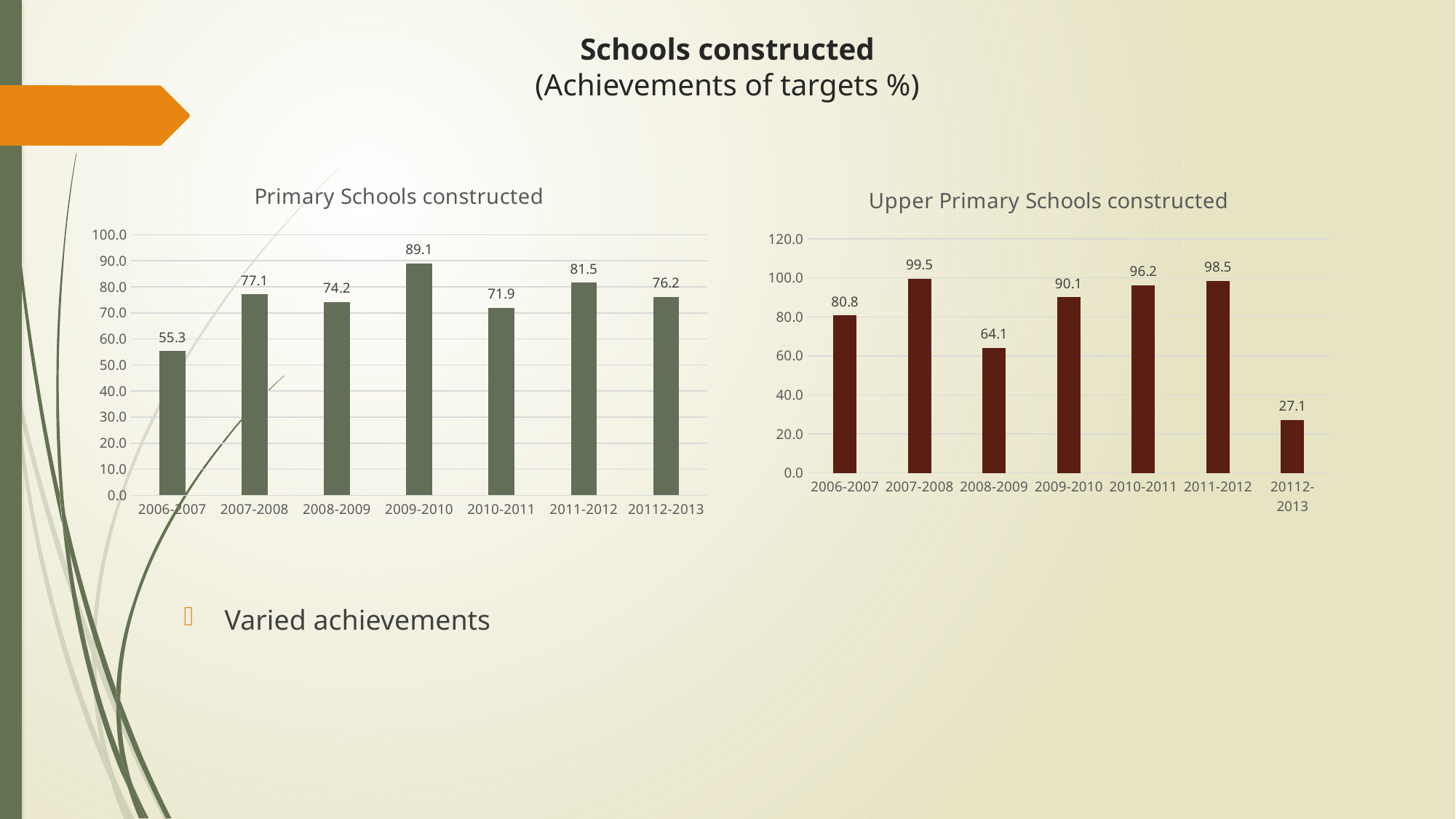
How many bars are in the 'Upper Primary Schools constructed' chart? 7 In the 'Primary Schools constructed' chart, is the value for 2011-2012 greater or less than 80? greater In the 'Primary Schools constructed' chart, what is the value for 2009-2010? 89.1 In the 'Primary Schools constructed' chart, which year has the lowest value? 2006-2007 What is the title of the chart on the right side of the slide? Upper Primary Schools constructed What type of chart is the 'Primary Schools constructed' chart? Bar chart In the 'Upper Primary Schools constructed' chart, what is the difference between the values for 2007-2008 and 2008-2009? 35.4 In the 'Primary Schools constructed' chart, what is the difference between the values for 2009-2010 and 2006-2007? 33.8 In the 'Upper Primary Schools constructed' chart, which year has the lowest value? 20112-2013 In the 'Primary Schools constructed' chart, which is larger: the value for 2007-2008 or the value for 2010-2011? 2007-2008 In the 'Upper Primary Schools constructed' chart, which year has the highest value? 2007-2008 In the 'Upper Primary Schools constructed' chart, what is the value for 2008-2009? 64.1